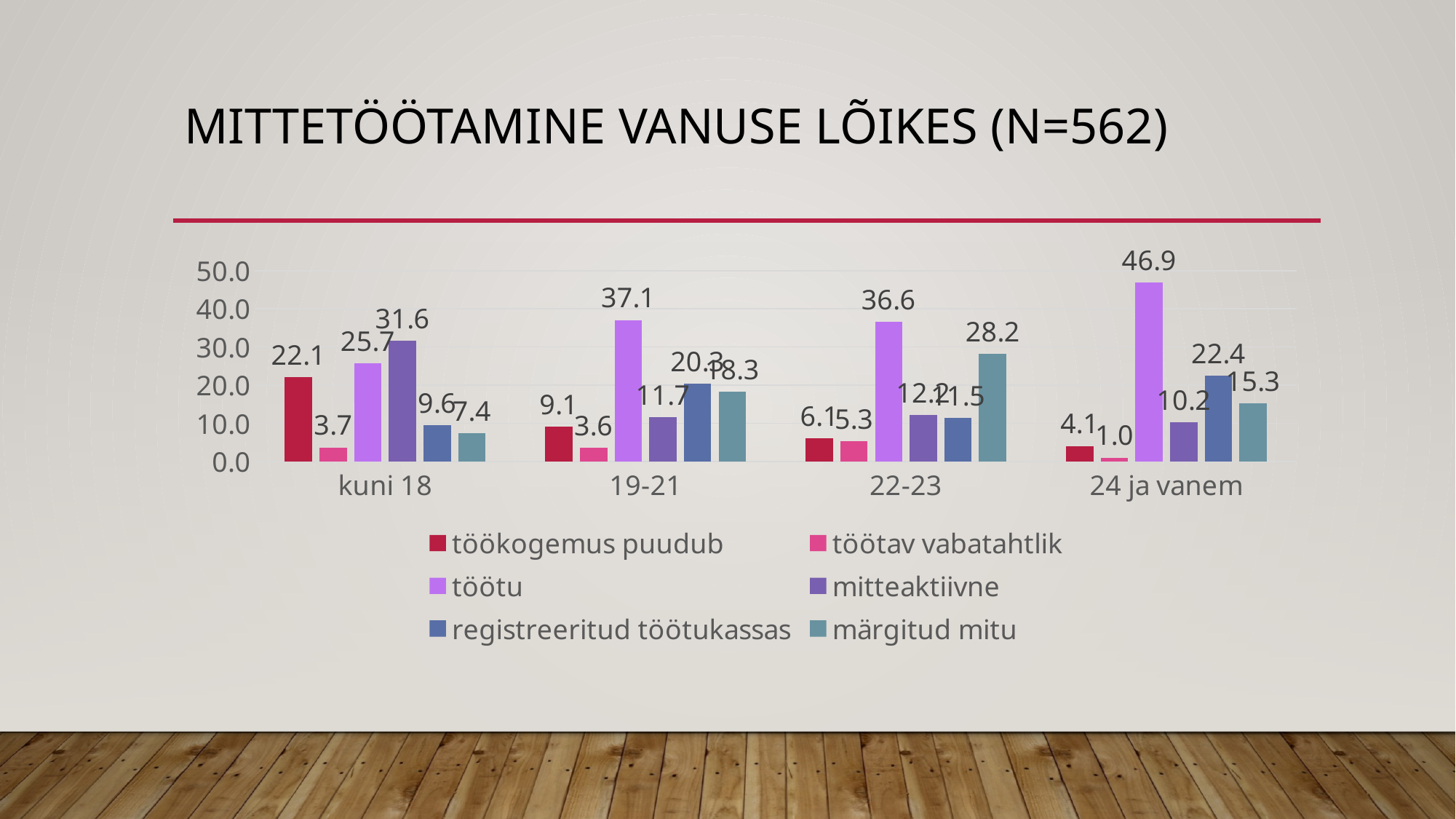
What kind of chart is shown on the slide? bar chart Which age group has the highest value for töötu? 24 ja vanem Does the value for töökogemus puudub rise or fall across the age groups from kuni 18 to 24 ja vanem? fall How many age groups are shown on the x axis? 4 Is the value for registreeritud töötukassas in the 24 ja vanem group greater or less than 20? greater What is the value for märgitud mitu in the 22-23 age group? 28.2 How many series does the legend list? 6 Which age group has the lowest value for töötav vabatahtlik? 24 ja vanem In the kuni 18 age group, which is larger: mitteaktiivne or töötu? mitteaktiivne What is the difference between the töötu values for 24 ja vanem and 19-21? 9.8 What is the value for töökogemus puudub in the kuni 18 age group? 22.1 What is the value for töötu in the 24 ja vanem age group? 46.9